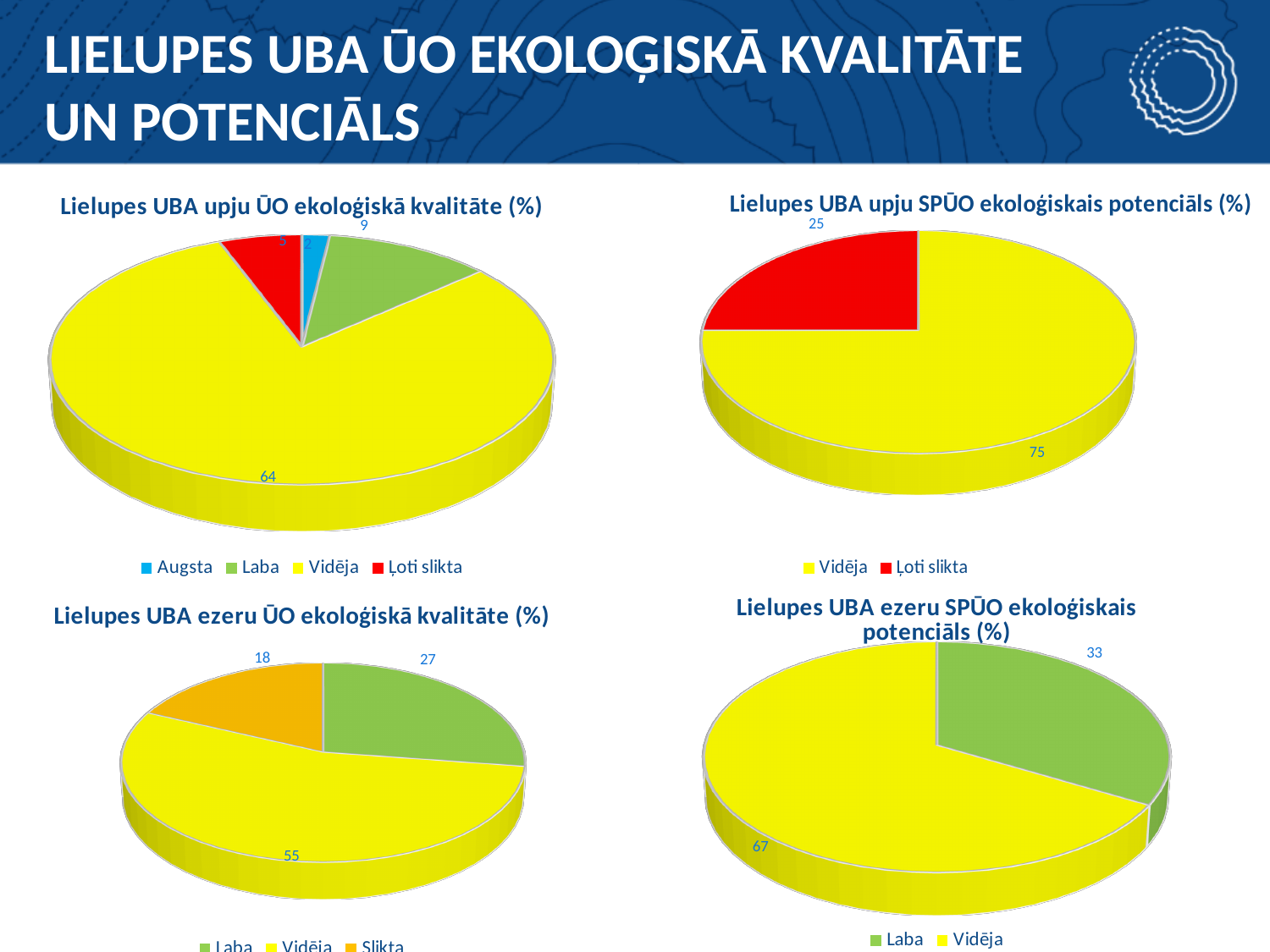
In the chart titled "Lielupes UBA ezeru SPŪO ekoloģiskais potenciāls (%)", what is the value for Laba? 33 In the chart titled "Lielupes UBA ezeru ŪO ekoloģiskā kvalitāte (%)", what is the value for Slikta? 18 In the chart titled "Lielupes UBA upju ŪO ekoloģiskā kvalitāte (%)", what is the value for Vidēja? 64 How many categories does the legend of the chart titled "Lielupes UBA upju ŪO ekoloģiskā kvalitāte (%)" list? 4 In the chart titled "Lielupes UBA upju SPŪO ekoloģiskais potenciāls (%)", what colour is the Ļoti slikta slice? Red What kind of chart is the chart titled "Lielupes UBA ezeru SPŪO ekoloģiskais potenciāls (%)"? Pie chart In the chart titled "Lielupes UBA ezeru ŪO ekoloģiskā kvalitāte (%)", what is the difference between the values for Laba and Slikta? 9 In the chart titled "Lielupes UBA upju ŪO ekoloģiskā kvalitāte (%)", what is the value for Laba? 9 In the chart titled "Lielupes UBA upju SPŪO ekoloģiskais potenciāls (%)", what is the value for Vidēja? 75 In the chart titled "Lielupes UBA ezeru SPŪO ekoloģiskais potenciāls (%)", which is larger, Laba or Vidēja? Vidēja In the chart titled "Lielupes UBA ezeru ŪO ekoloģiskā kvalitāte (%)", which category has the largest share? Vidēja In the chart titled "Lielupes UBA upju SPŪO ekoloģiskais potenciāls (%)", what is the value for Ļoti slikta? 25